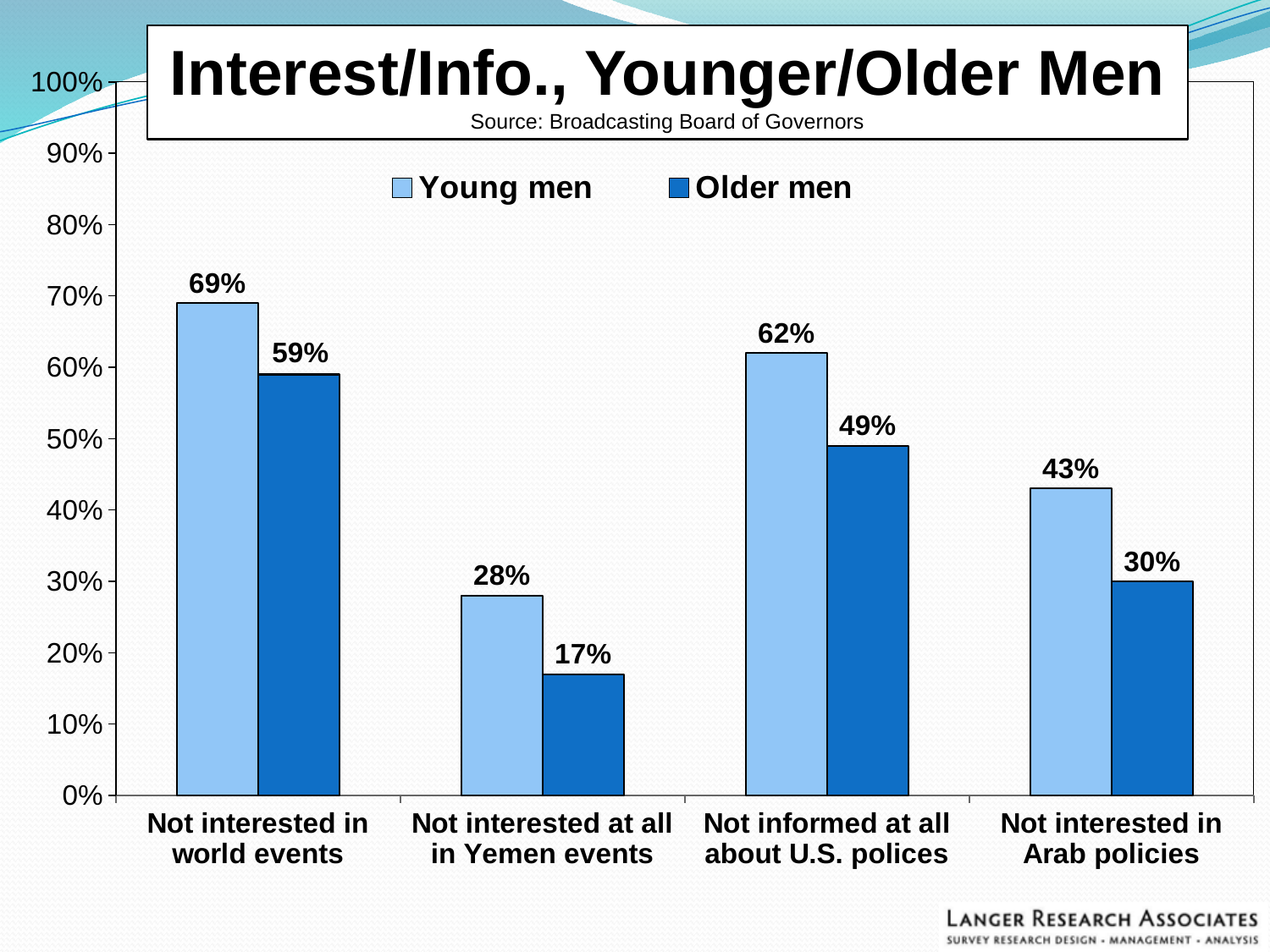
How many categories are shown on the x axis? 4 What is the value for Older men in the 'Not interested at all in Yemen events' category? 17% What is the difference between Young men and Older men in the 'Not informed at all about U.S. polices' category? 13% What is the value for Older men in the 'Not informed at all about U.S. polices' category? 49% What is the value for Young men in the 'Not interested in Arab policies' category? 43% What source is cited under the chart title? Broadcasting Board of Governors How many series does the legend list? 2 Which category has the highest value for Young men? Not interested in world events What kind of chart is shown on the slide? Bar chart Which category has the lowest value for Older men? Not interested at all in Yemen events What is the value for Young men in the 'Not interested in world events' category? 69% Which is larger in the 'Not interested in Arab policies' category: Young men or Older men? Young men